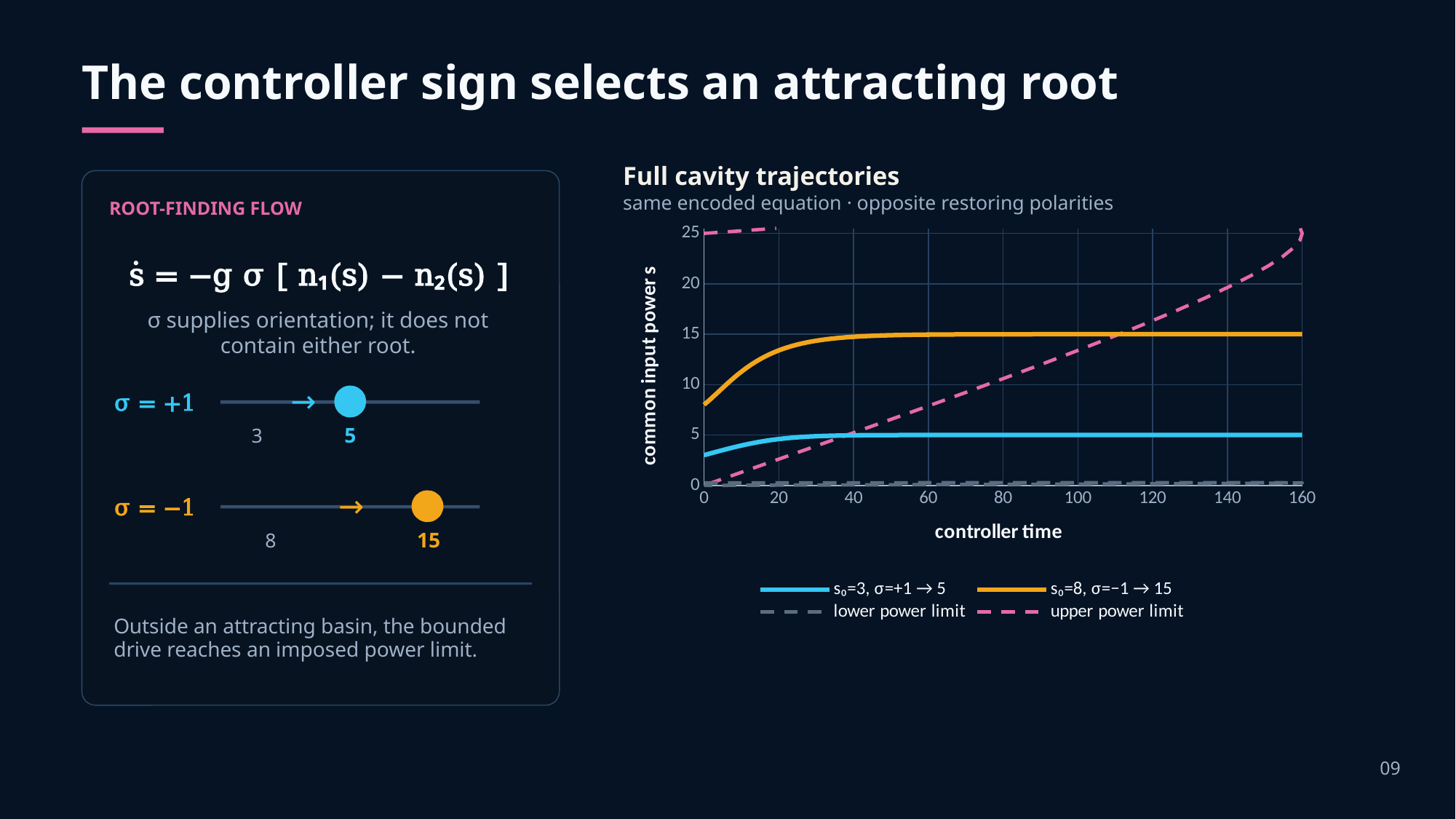
In the "Full cavity trajectories" chart, is the upper power limit at controller time 160 greater or less than 20? greater What kind of chart is shown under "Full cavity trajectories"? line chart In the "Full cavity trajectories" chart, is the s₀=8, σ=−1 trajectory at controller time 100 greater or less than 10? greater What is the y-axis label of the "Full cavity trajectories" chart? common input power s In the "Full cavity trajectories" chart, which settles at a higher value: the σ=+1 trajectory or the σ=−1 trajectory? the σ=−1 trajectory How many series does the legend of the "Full cavity trajectories" chart list? 4 What is the x-axis label of the "Full cavity trajectories" chart? controller time In the "Full cavity trajectories" chart, does the upper power limit rise or fall as controller time increases? rise In the "Full cavity trajectories" chart, what value does the s₀=8, σ=−1 trajectory settle at? 15 In the "Full cavity trajectories" chart, what is the difference between the settled values of the σ=−1 and σ=+1 trajectories? 10 In the "Full cavity trajectories" chart, what value does the s₀=3, σ=+1 trajectory settle at? 5 In the "Full cavity trajectories" chart, is the s₀=3, σ=+1 trajectory at controller time 120 greater or less than 10? less